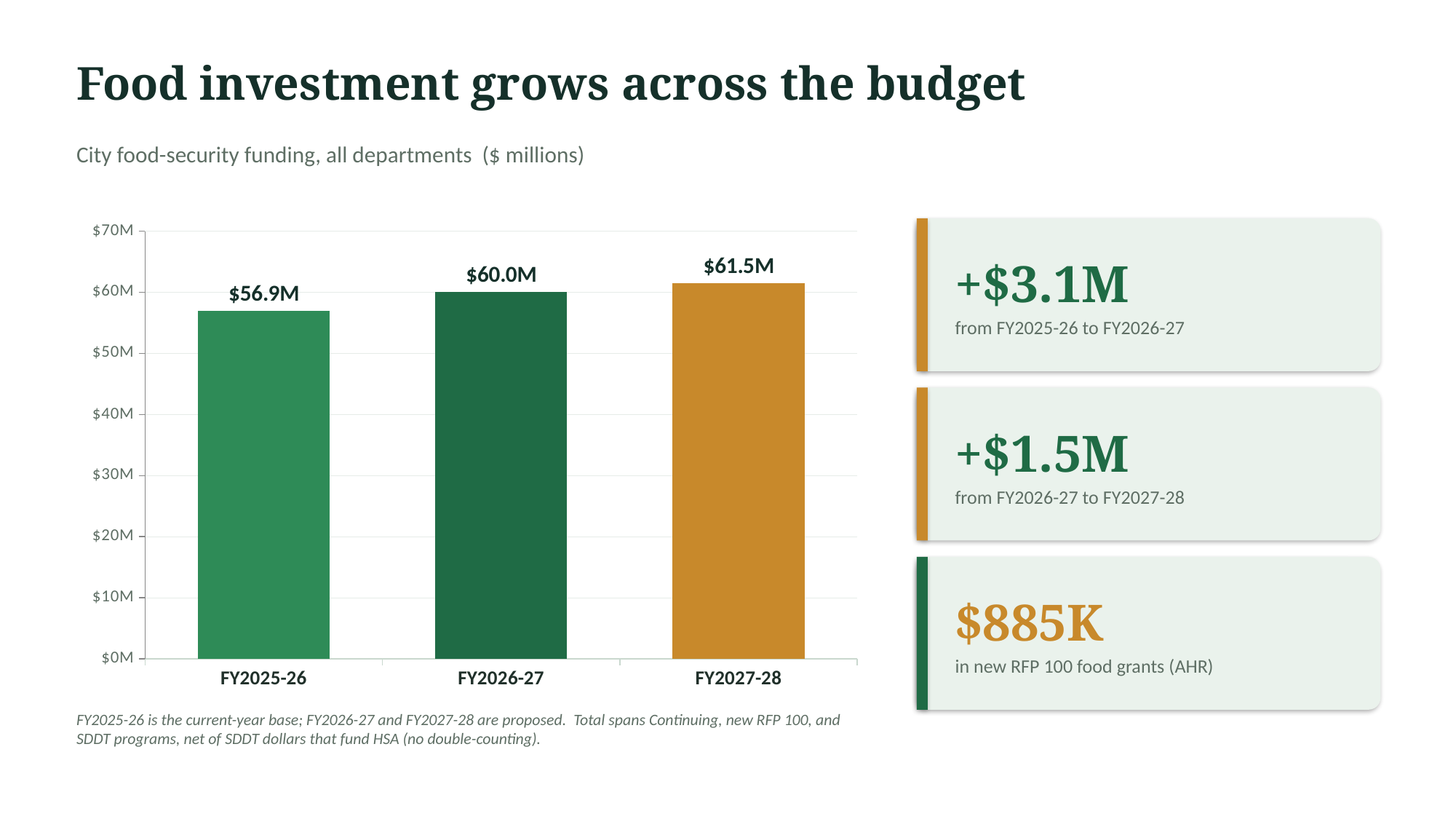
Do the values rise or fall from FY2025-26 to FY2027-28? rise What is the value for FY2026-27? $60.0M Which is larger, the value for FY2026-27 or FY2025-26? FY2026-27 What is the value for FY2025-26? $56.9M What is the difference between the FY2026-27 and FY2025-26 values? $3.1M What is the value for FY2027-28? $61.5M Which fiscal year has the highest funding? FY2027-28 How many fiscal years are shown on the chart? 3 Which fiscal year has the lowest funding? FY2025-26 What kind of chart is shown on the slide? bar chart Is the value for FY2025-26 greater or less than $60M? less What is the difference between the FY2027-28 and FY2025-26 values? $4.6M